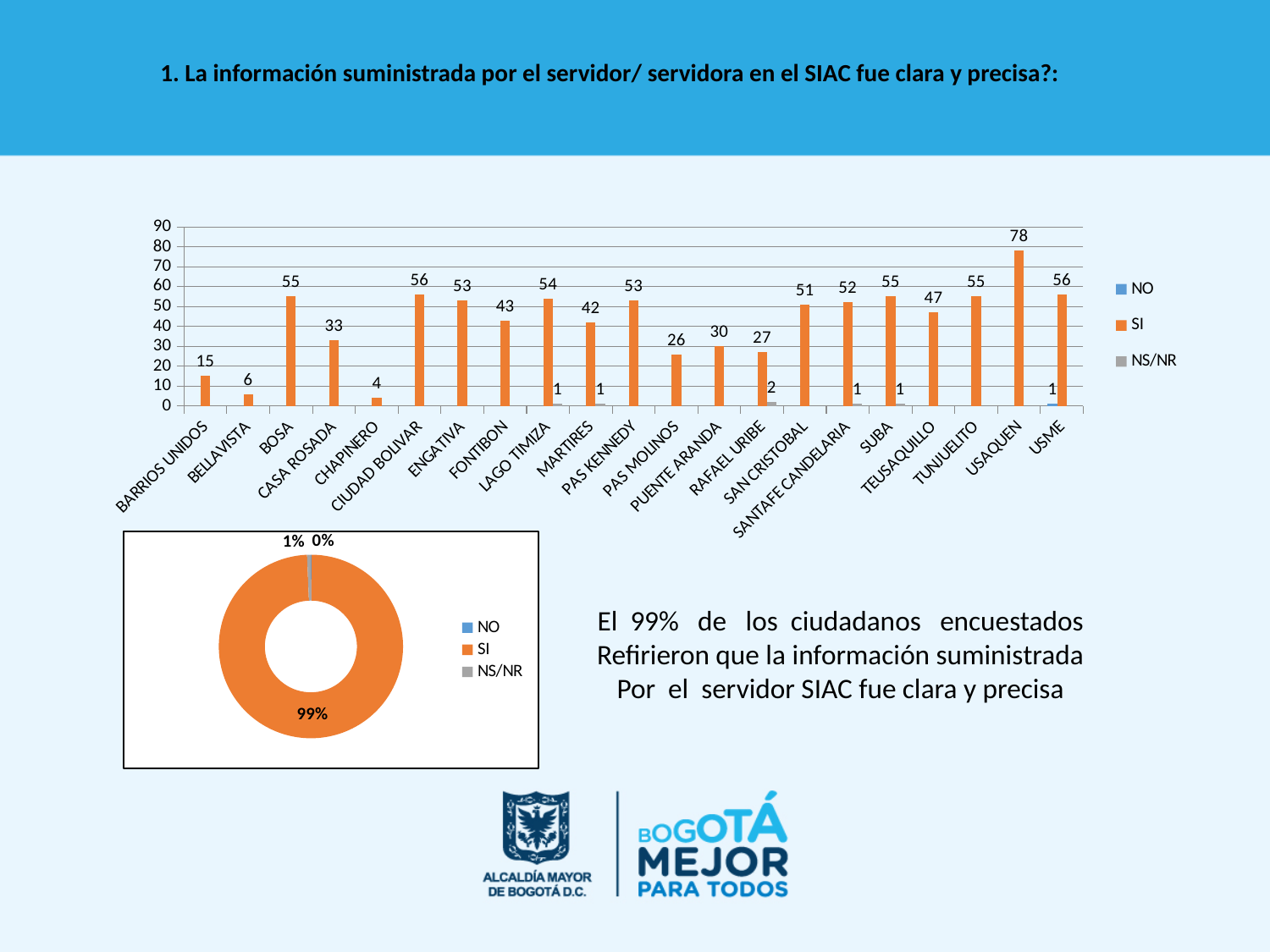
What kind of chart is the top chart on the slide? Bar chart In the bar chart, which category has the lowest SI value? CHAPINERO In the bar chart, how many categories are shown on the x axis? 21 In the bar chart, what is the SI value for USAQUEN? 78 In the bar chart, what is the SI value for FONTIBON? 43 In the bar chart, what is the SI value for CHAPINERO? 4 In the bar chart, which has a larger SI value, CASA ROSADA or TEUSAQUILLO? TEUSAQUILLO In the bar chart, what is the difference between the SI values for USAQUEN and BOSA? 23 In the bar chart, which category has the highest SI value? USAQUEN In the doughnut chart at the bottom left, what share does SI have? 99% In the doughnut chart at the bottom left, what share does NO have? 0% In the bar chart, how many series does the legend list? 3